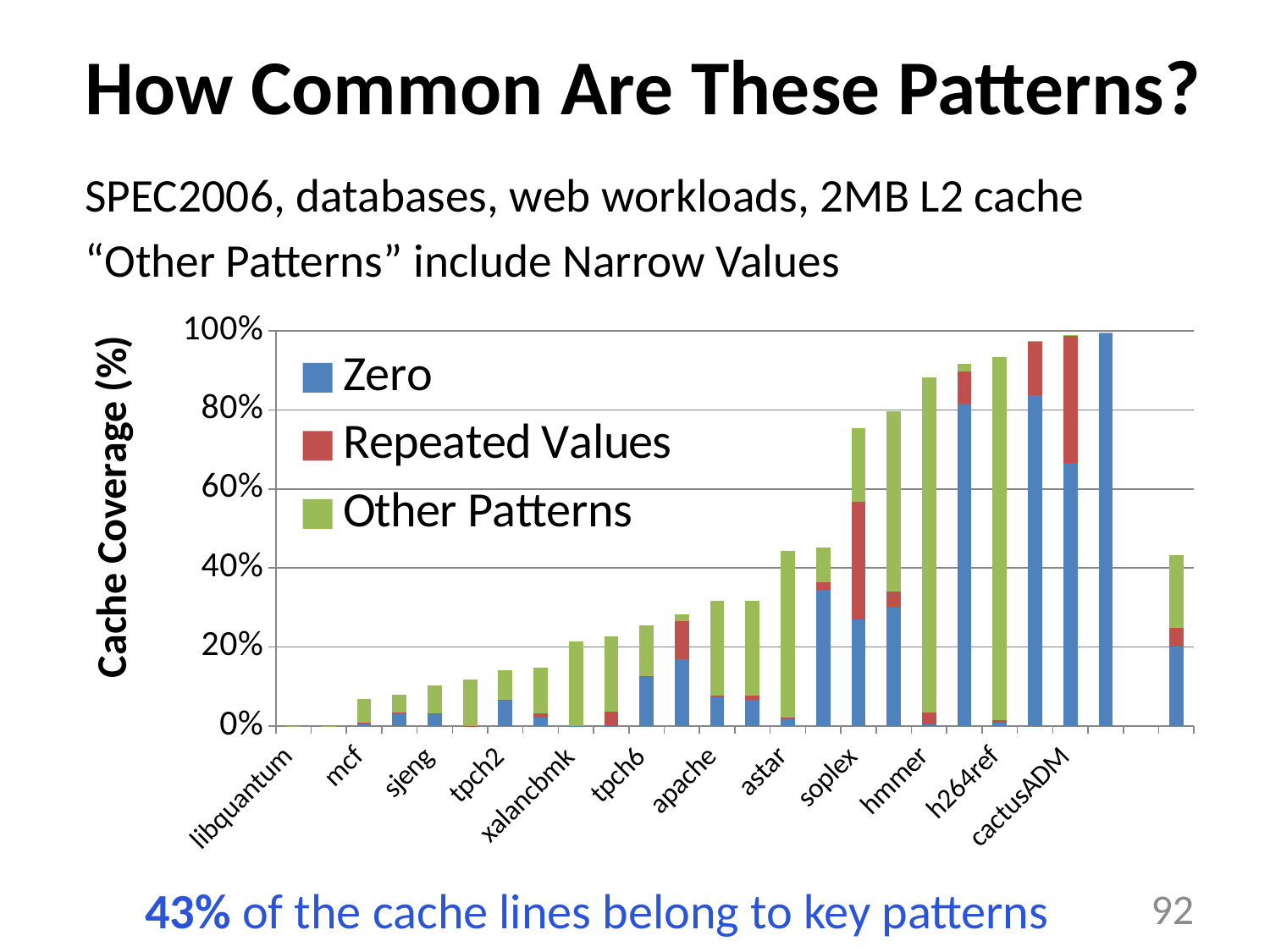
Which has the larger total cache coverage, cactusADM or libquantum? cactusADM Is the total cache coverage for astar greater or less than 60%? less Is the total cache coverage for h264ref greater or less than 80%? greater Do the total bar heights generally rise or fall moving from left to right along the x axis? Rise What kind of chart is shown on the slide? Stacked bar chart Is the total cache coverage for soplex greater or less than 60%? greater How many series does the chart's legend list? 3 What are the three series named in the chart's legend? Zero, Repeated Values, Other Patterns What is the label of the chart's vertical axis? Cache Coverage (%)